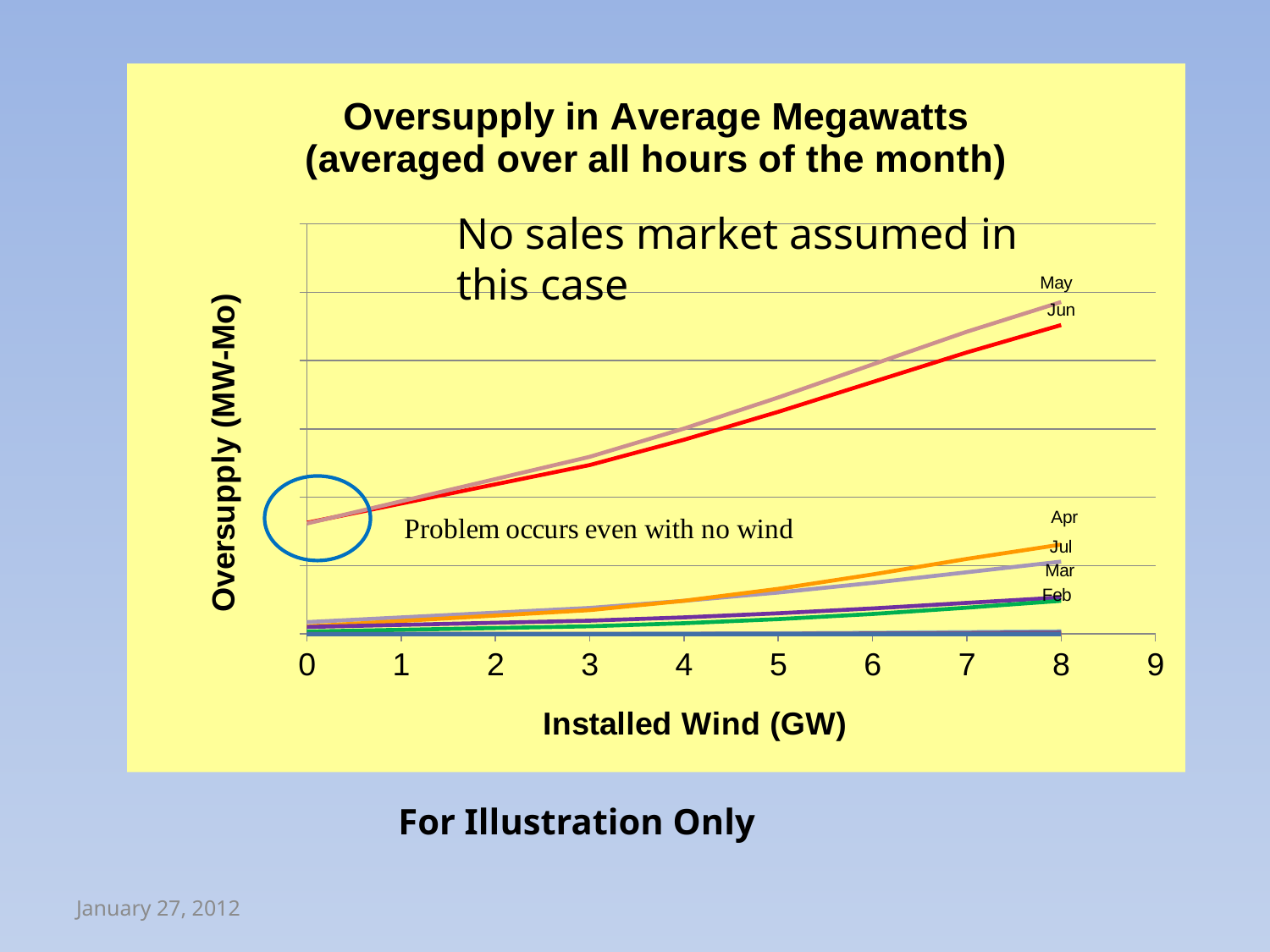
Which month's line is highest at 8 GW of installed wind? May How many month labels are shown at the right end of the lines? 6 Which month's line is lowest at 8 GW of installed wind among the labelled lines? Feb What kind of chart is shown on the slide? line chart At 8 GW of installed wind, which is larger, the oversupply for May or for Jun? May At 8 GW of installed wind, which is larger, the oversupply for Jun or for Apr? Jun At 8 GW of installed wind, which is larger, the oversupply for Apr or for Jul? Apr What is the highest value shown on the x axis? 9 What is the label of the x axis? Installed Wind (GW) Does the Apr line rise or fall as installed wind increases from 0 to 8 GW? rise What is the title of the chart? Oversupply in Average Megawatts (averaged over all hours of the month) Does the May line rise or fall as installed wind increases from 0 to 8 GW? rise